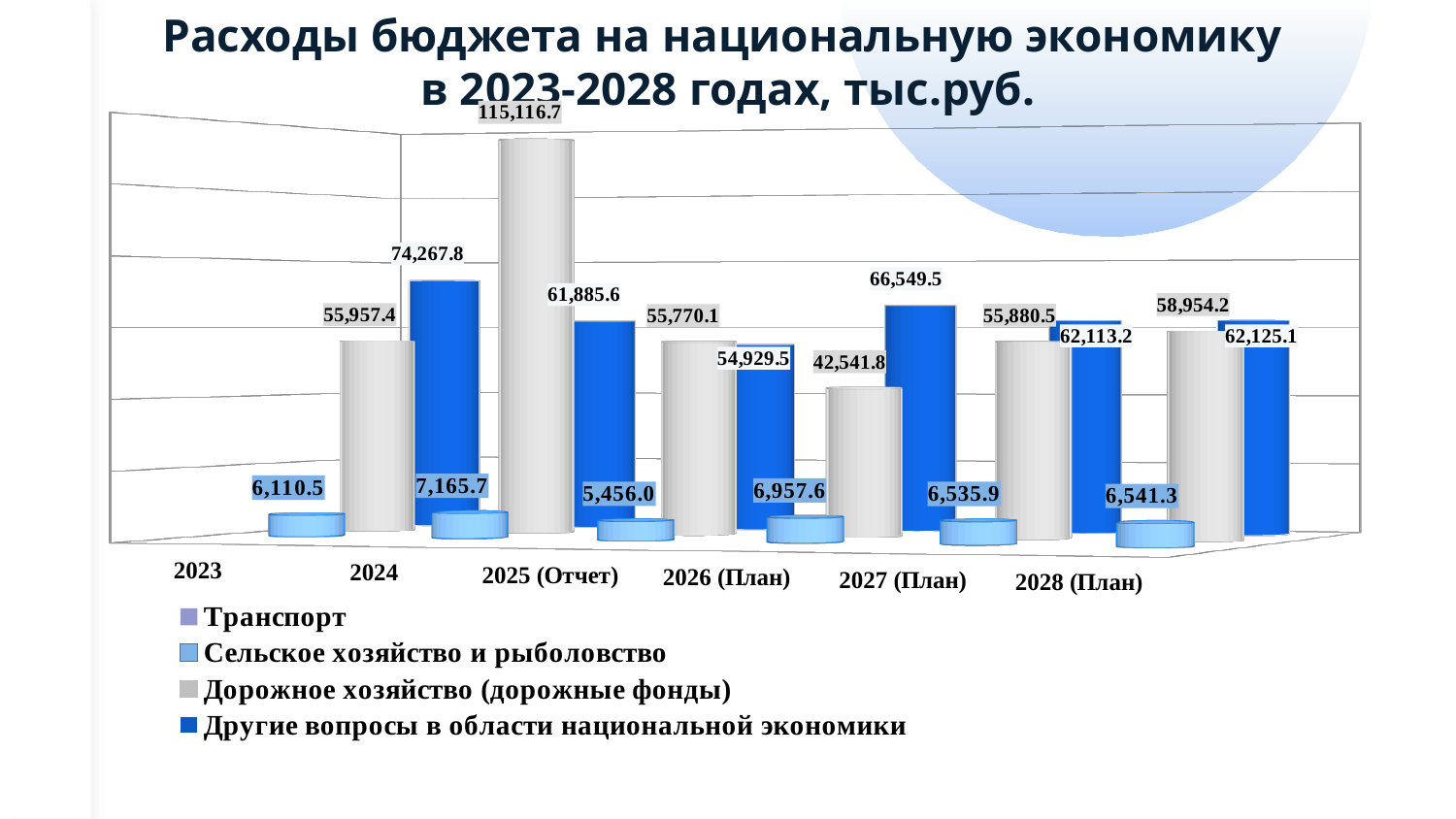
What is the value for Другие вопросы в области национальной экономики in 2028 (План)? 62,125.1 How many series does the legend list? 4 In which year is the value for Сельское хозяйство и рыболовство the lowest? 2025 (Отчет) What is the value for Дорожное хозяйство (дорожные фонды) in 2024? 115,116.7 What kind of chart is shown on the slide? Bar chart In 2026 (План), which is larger: Дорожное хозяйство (дорожные фонды) or Другие вопросы в области национальной экономики? Другие вопросы в области национальной экономики What is the difference between the values for Другие вопросы в области национальной экономики in 2023 and 2024? 12,382.2 How many year categories are shown on the x axis? 6 In which year is the value for Другие вопросы в области национальной экономики the highest? 2023 In which year is the value for Дорожное хозяйство (дорожные фонды) the highest? 2024 What is the value for Сельское хозяйство и рыболовство in 2025 (Отчет)? 5,456.0 What is the title of the chart? Расходы бюджета на национальную экономику в 2023-2028 годах, тыс.руб.